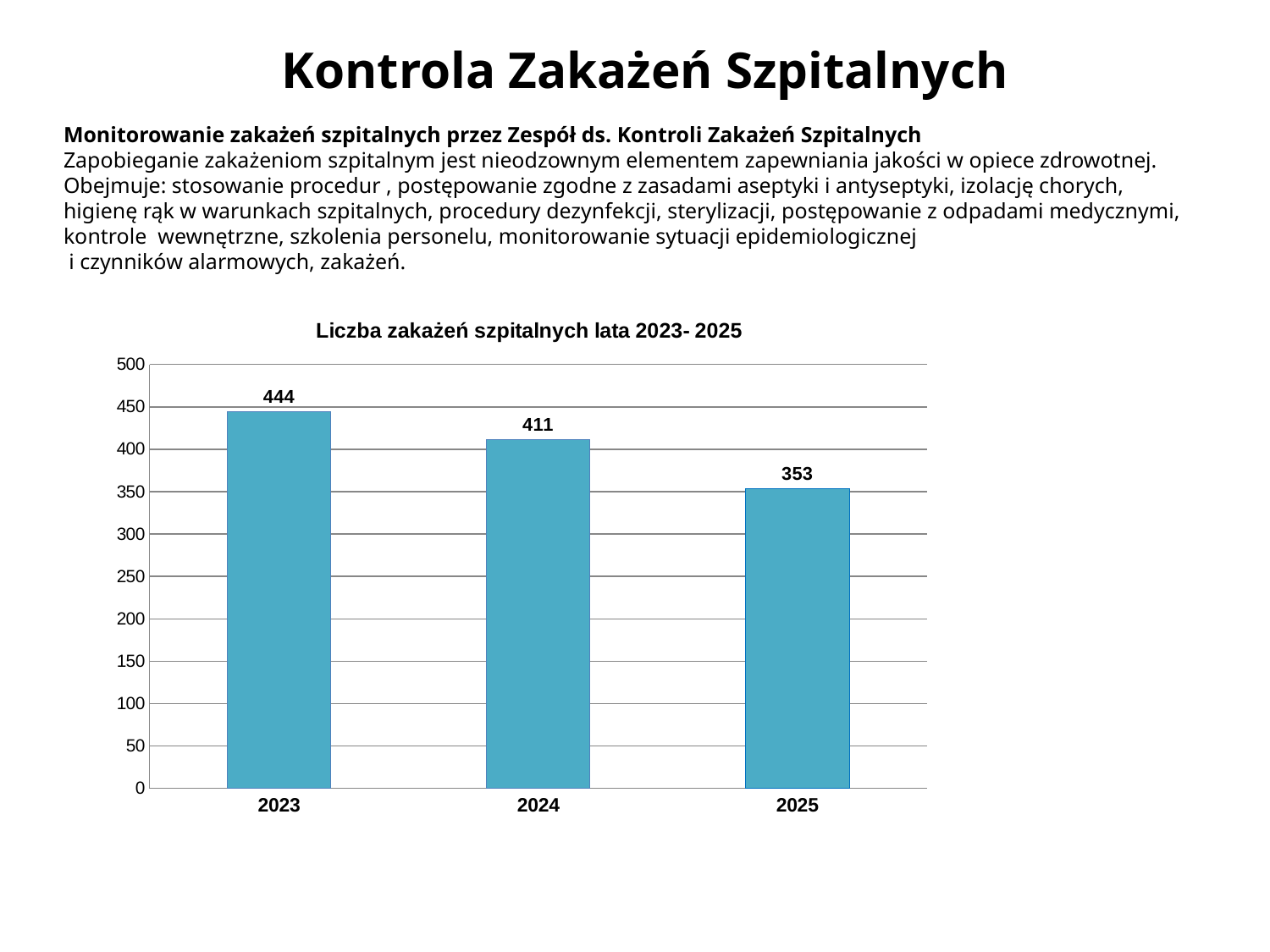
What kind of chart is shown on the slide? bar chart Do the values rise or fall from 2023 to 2025? fall How many years are shown on the chart? 3 Which year has a larger value, 2024 or 2025? 2024 Is the value for 2025 greater or less than 400? less Which year has the lowest number of hospital infections? 2025 Which year has the highest number of hospital infections? 2023 What is the difference between the values for 2023 and 2024? 33 What is the number of hospital infections shown for 2025? 353 What is the difference between the values for 2023 and 2025? 91 What is the number of hospital infections shown for 2024? 411 What is the number of hospital infections shown for 2023? 444